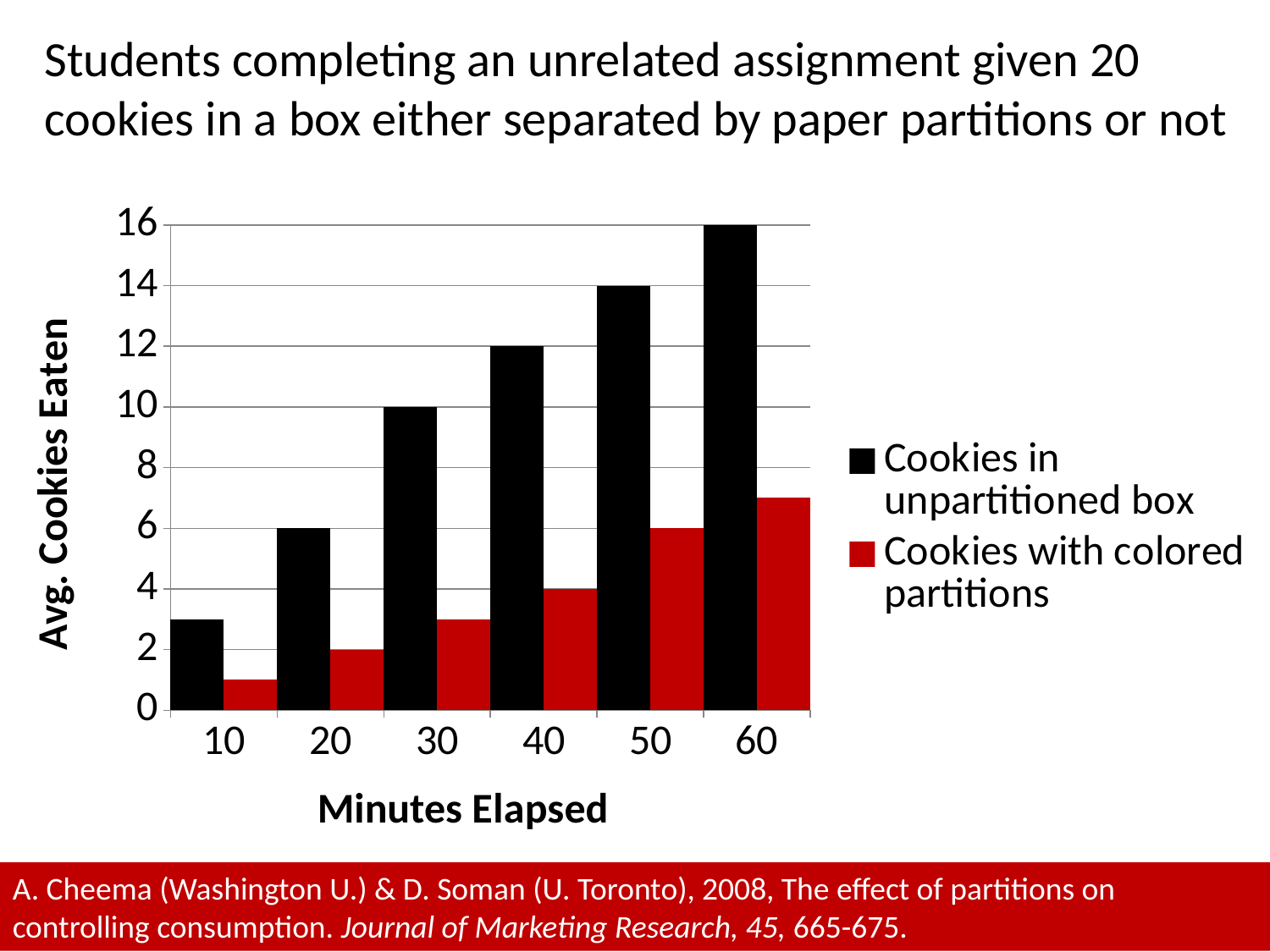
What is the difference between cookies eaten from the unpartitioned box and cookies eaten with colored partitions at 40 minutes? 8 What is the average number of cookies eaten with colored partitions at 40 minutes? 4 What kind of chart is shown on the slide? bar chart How many minute categories are shown on the x axis? 6 What is the average number of cookies eaten from the unpartitioned box at 60 minutes? 16 At which minute mark is the value for cookies in the unpartitioned box highest? 60 Is the value for cookies with colored partitions at 60 minutes greater or less than 8? less What is the average number of cookies eaten from the unpartitioned box at 30 minutes? 10 At which minute mark is the value for cookies with colored partitions lowest? 10 How many series does the legend list? 2 Do the values for cookies in the unpartitioned box rise or fall as minutes elapsed increase? rise What is the average number of cookies eaten with colored partitions at 50 minutes? 6